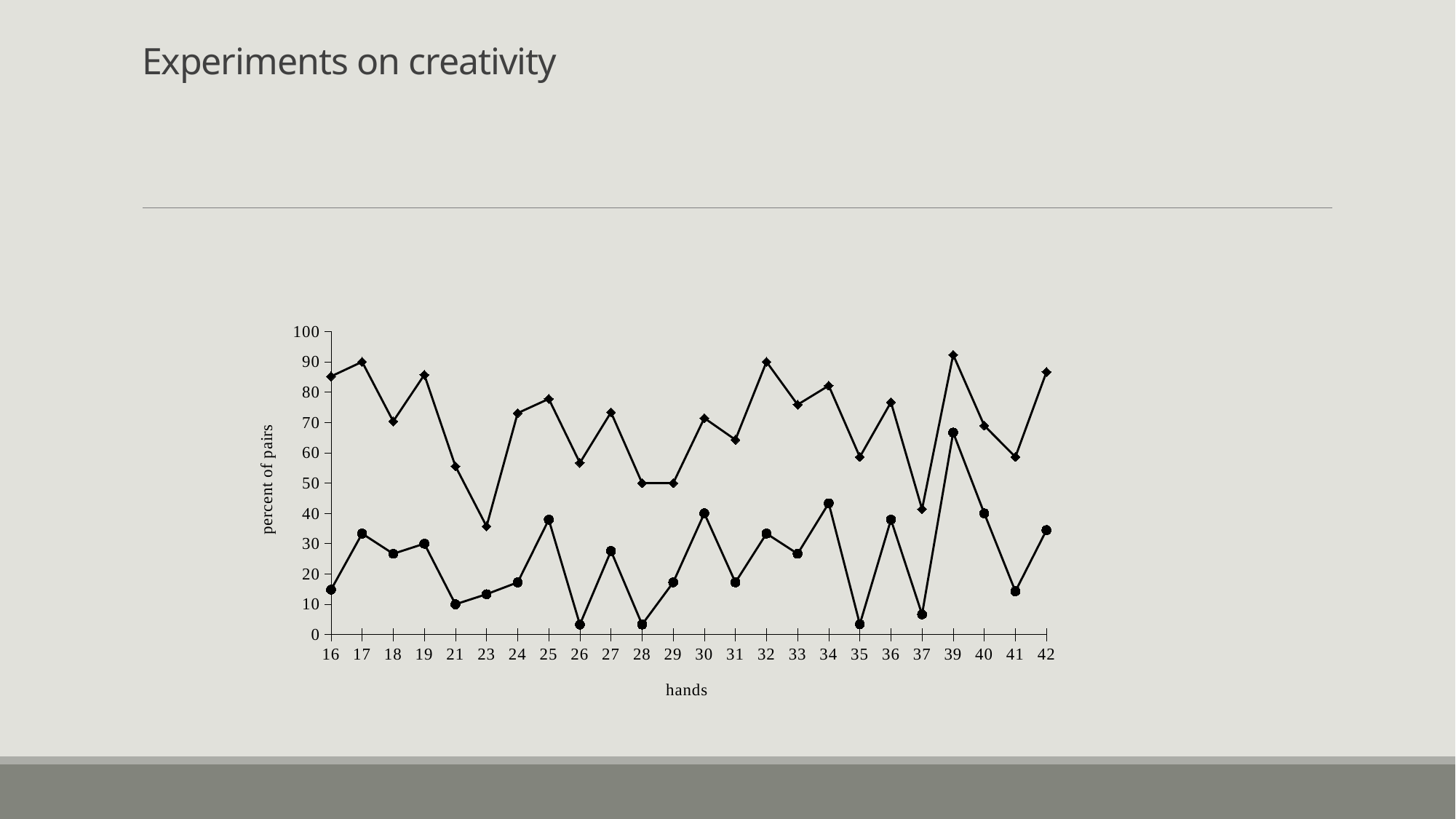
How many hands are plotted along the x axis? 24 What is the label of the x axis? hands What is the label of the y axis? percent of pairs What kind of chart is shown on the slide? line chart Is the value of the circle-marker series at hand 34 greater or less than 30? greater Is the value of the diamond-marker series at hand 23 greater or less than 50? less Does the circle-marker series rise or fall from hand 25 to hand 26? fall Is the value of the circle-marker series at hand 26 greater or less than 10? less Which is larger for the diamond-marker series: the value at hand 16 or the value at hand 21? hand 16 At which hand does the circle-marker series reach its highest value? 39